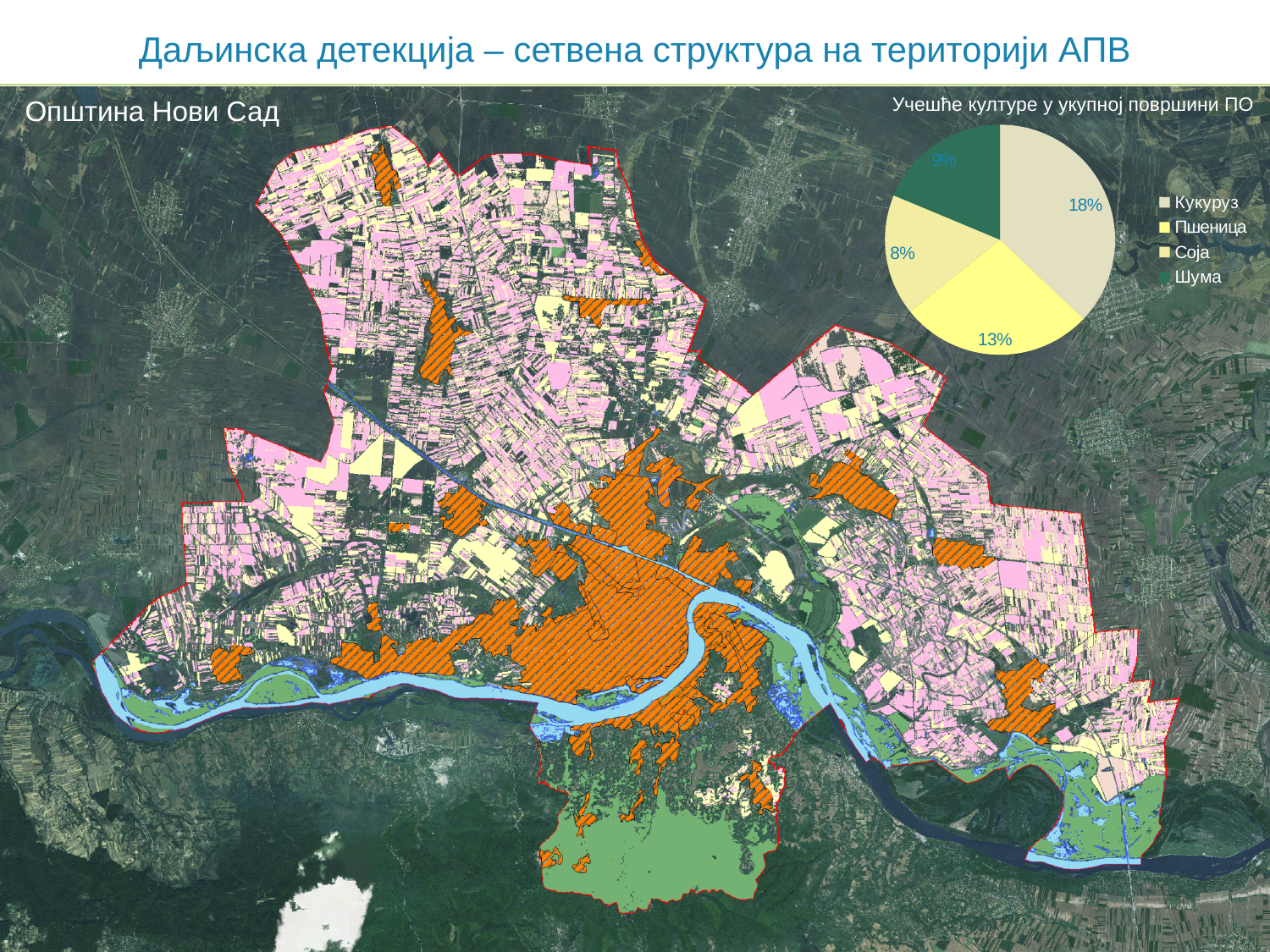
What is the difference between the percentages shown for Кукуруз and Пшеница? 5% What percentage is shown for Кукуруз in the pie chart? 18% Which category in the pie chart is shown in dark green? Шума Which category has the smallest slice in the pie chart? Соја What type of chart is shown on the slide? pie chart What is the title of the pie chart? Учешће културе у укупној површини ПО Which category has the largest slice in the pie chart? Кукуруз How many categories does the pie chart's legend list? 4 What percentage is shown for Соја in the pie chart? 8% Which is larger in the pie chart, Пшеница or Шума? Пшеница What percentage is shown for Пшеница in the pie chart? 13% What percentage is shown for Шума in the pie chart? 9%